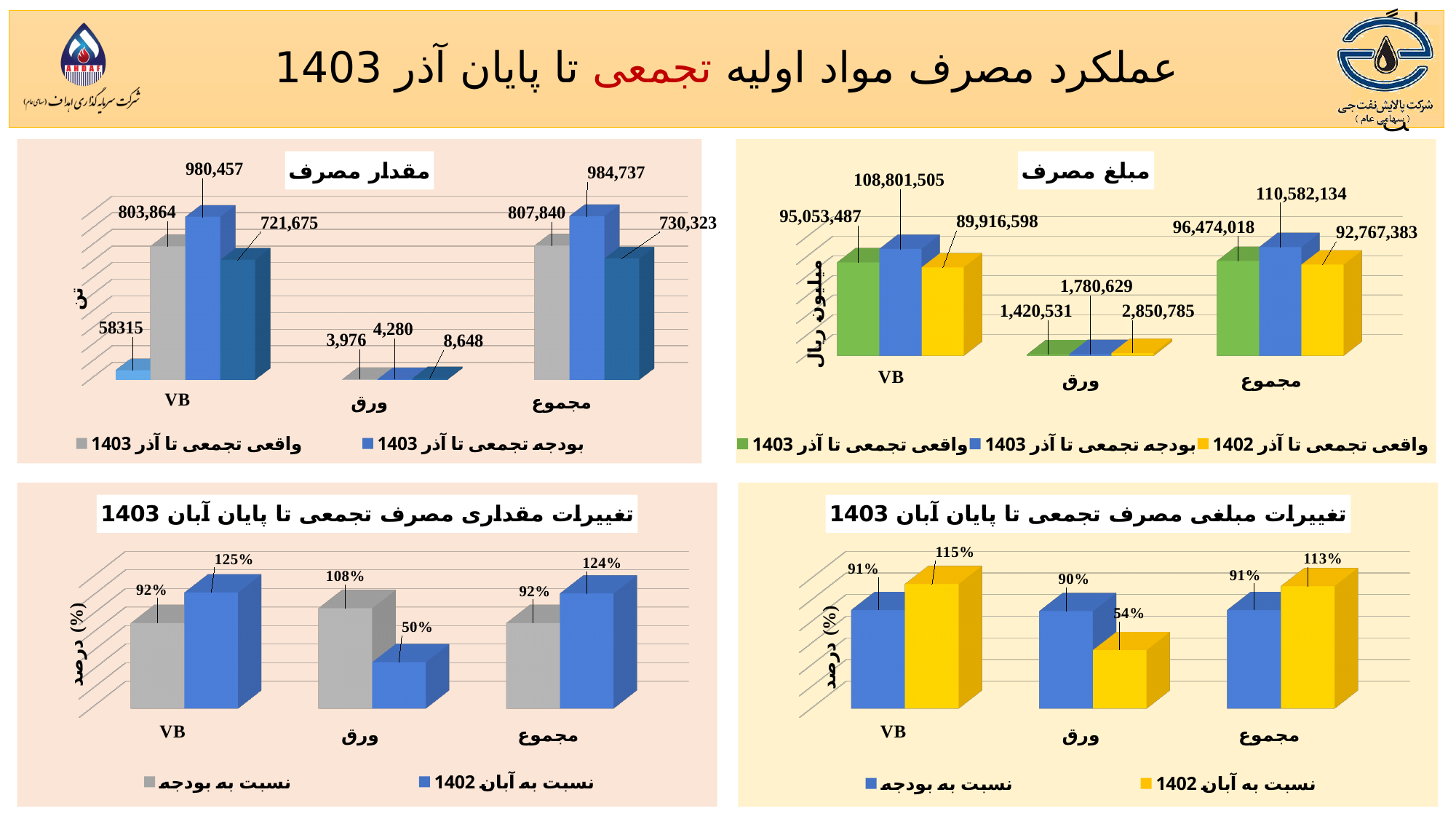
How many categories are shown on the x axis of the bottom-left chart? 3 In the top-left chart titled مقدار مصرف, what is the value of the بودجه تجمعی تا آذر 1403 series for مجموع? 984,737 How many series does the legend of the top-right chart titled مبلغ مصرف list? 3 In the top-left chart titled مقدار مصرف, what is the value of the واقعی تجمعی تا آذر 1403 series for ورق? 3,976 In the top-right chart titled مبلغ مصرف, what is the value of the واقعی تجمعی تا آذر 1402 series for مجموع? 92,767,383 In the bottom-right chart, what is the نسبت به بودجه value for VB? 91% In the bottom-left chart, what is the نسبت به آبان 1402 value for ورق? 50% In the bottom-right chart, which category has the highest نسبت به آبان 1402 value? VB In the bottom-right chart, which is larger for مجموع: نسبت به بودجه or نسبت به آبان 1402? نسبت به آبان 1402 In the top-right chart titled مبلغ مصرف, what is the difference between the بودجه تجمعی تا آذر 1403 value and the واقعی تجمعی تا آذر 1403 value for ورق? 360,098 In the top-right chart titled مبلغ مصرف, what is the value of the بودجه تجمعی تا آذر 1403 series for VB? 108,801,505 In the bottom-left chart, which category has the lowest نسبت به آبان 1402 value? ورق